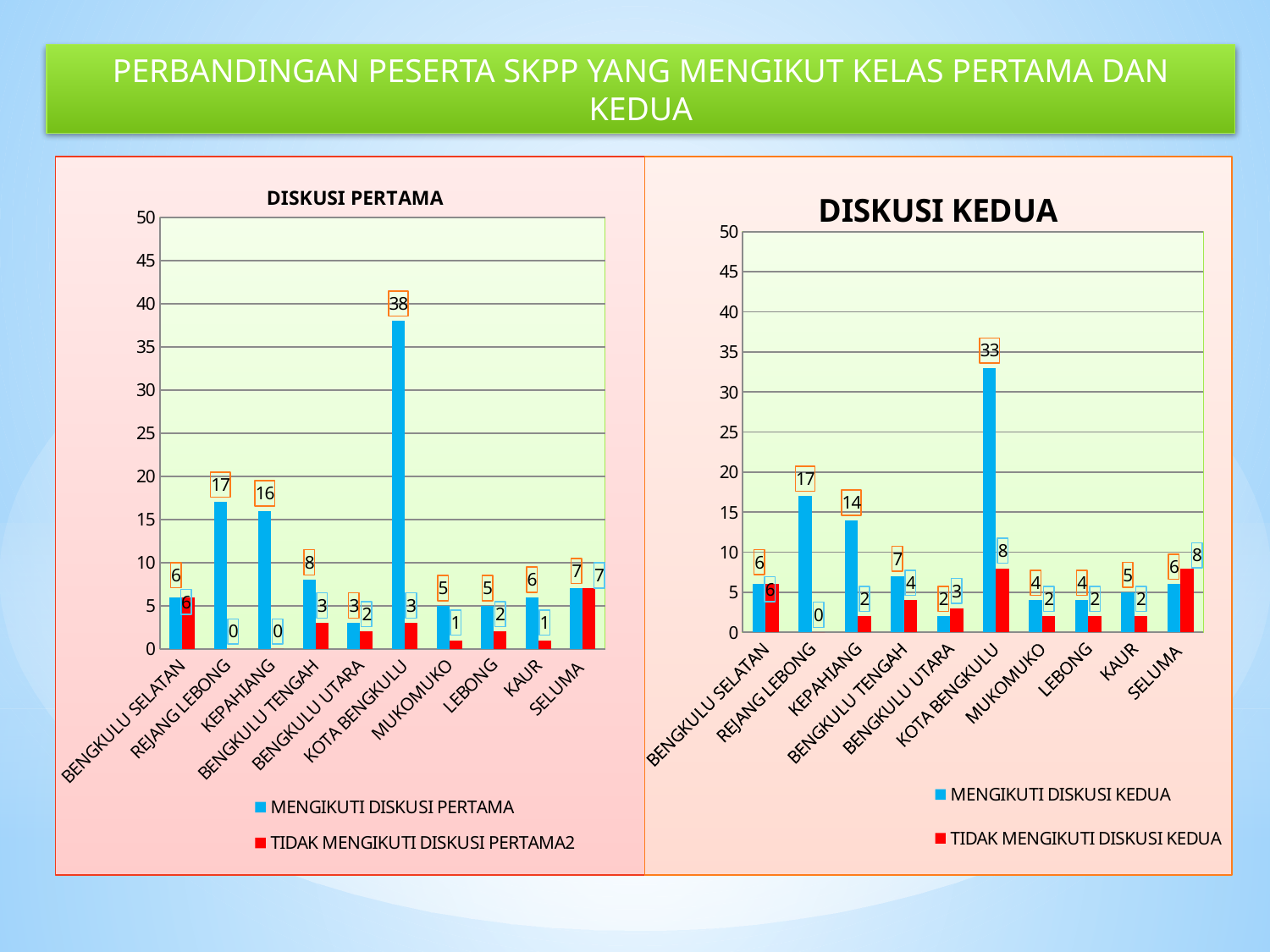
What is the difference between the MENGIKUTI value for KOTA BENGKULU in the DISKUSI PERTAMA chart and in the DISKUSI KEDUA chart? 5 In the DISKUSI KEDUA chart, what is the value of TIDAK MENGIKUTI DISKUSI KEDUA for KOTA BENGKULU? 8 In the DISKUSI KEDUA chart, what is the value of MENGIKUTI DISKUSI KEDUA for KEPAHIANG? 14 In the DISKUSI KEDUA chart, is the MENGIKUTI DISKUSI KEDUA value for KOTA BENGKULU greater or less than 30? greater In the DISKUSI PERTAMA chart, what is the value of MENGIKUTI DISKUSI PERTAMA for KOTA BENGKULU? 38 How many series does the legend of the DISKUSI KEDUA chart list? 2 How many categories are shown on the x axis of the DISKUSI PERTAMA chart? 10 What type of chart is the DISKUSI KEDUA chart? Bar chart In the DISKUSI PERTAMA chart, which category has the highest MENGIKUTI DISKUSI PERTAMA value? KOTA BENGKULU In the DISKUSI PERTAMA chart, what is the difference between MENGIKUTI DISKUSI PERTAMA for REJANG LEBONG and for KEPAHIANG? 1 In the DISKUSI PERTAMA chart, which is larger for REJANG LEBONG: MENGIKUTI DISKUSI PERTAMA or TIDAK MENGIKUTI DISKUSI PERTAMA2? MENGIKUTI DISKUSI PERTAMA In the DISKUSI KEDUA chart, which category has the lowest MENGIKUTI DISKUSI KEDUA value? BENGKULU UTARA